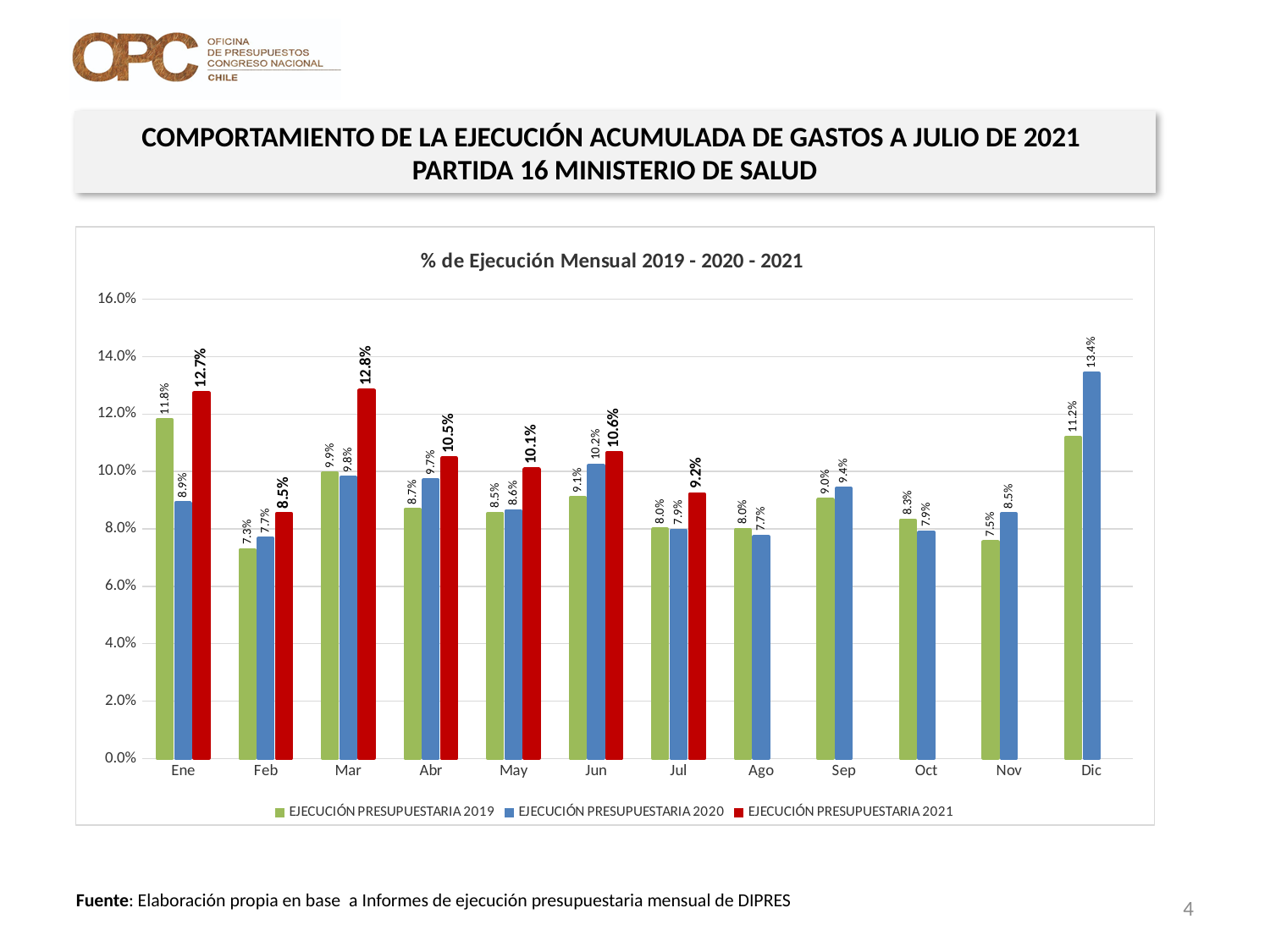
What is the title of the chart? % de Ejecución Mensual 2019 - 2020 - 2021 What is the value for EJECUCIÓN PRESUPUESTARIA 2021 in Mar? 12.8% Which is larger in Jun: the 2020 value or the 2019 value? 2020 (10.2%) What kind of chart is shown? Bar chart What is the value for EJECUCIÓN PRESUPUESTARIA 2019 in Ene? 11.8% How many months are shown on the x axis? 12 How many series does the legend list? 3 Which colour represents EJECUCIÓN PRESUPUESTARIA 2021? Red What is the difference between the 2021 and 2019 values in Ene? 0.9% Which month has the lowest value for EJECUCIÓN PRESUPUESTARIA 2019? Feb Which month has the highest value for EJECUCIÓN PRESUPUESTARIA 2020? Dic What is the value for EJECUCIÓN PRESUPUESTARIA 2020 in Dic? 13.4%